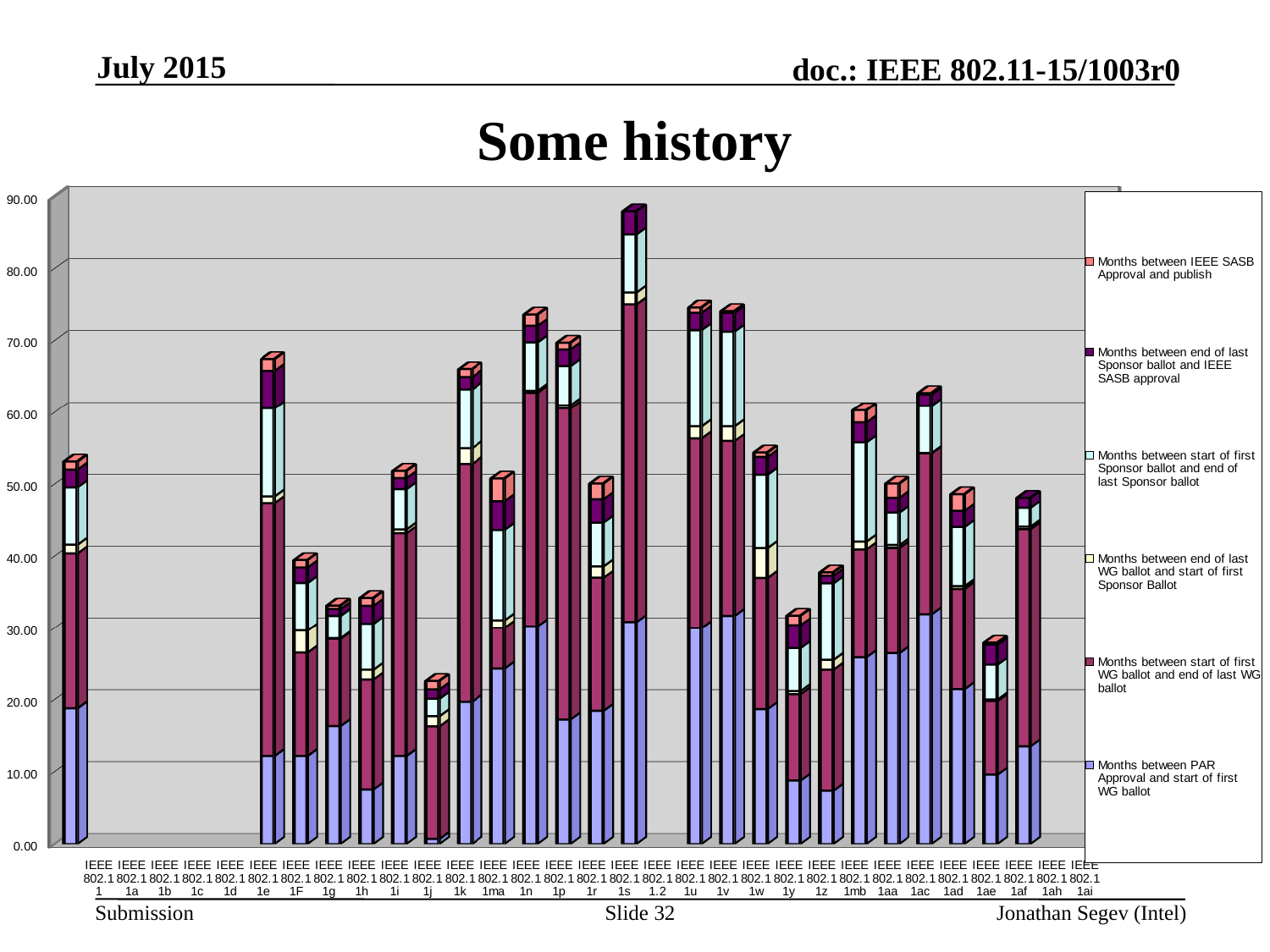
Is the total stacked value for IEEE 802.11s greater or less than 80? greater What is the title of the chart? Some history Which has the taller stacked bar, IEEE 802.11ae or IEEE 802.11ac? IEEE 802.11ac How many categories are shown along the x axis? 31 Which has the taller stacked bar, IEEE 802.11e or IEEE 802.11g? IEEE 802.11e What kind of chart is shown on the slide? stacked bar chart How many series does the legend list? 6 Is the total stacked value for IEEE 802.11j greater or less than 30? less Is the total stacked value for IEEE 802.11e greater or less than 60? greater Which series does the bottom segment of each stacked bar represent, according to the legend? Months between PAR Approval and start of first WG ballot Which category has the tallest stacked bar? IEEE 802.11s